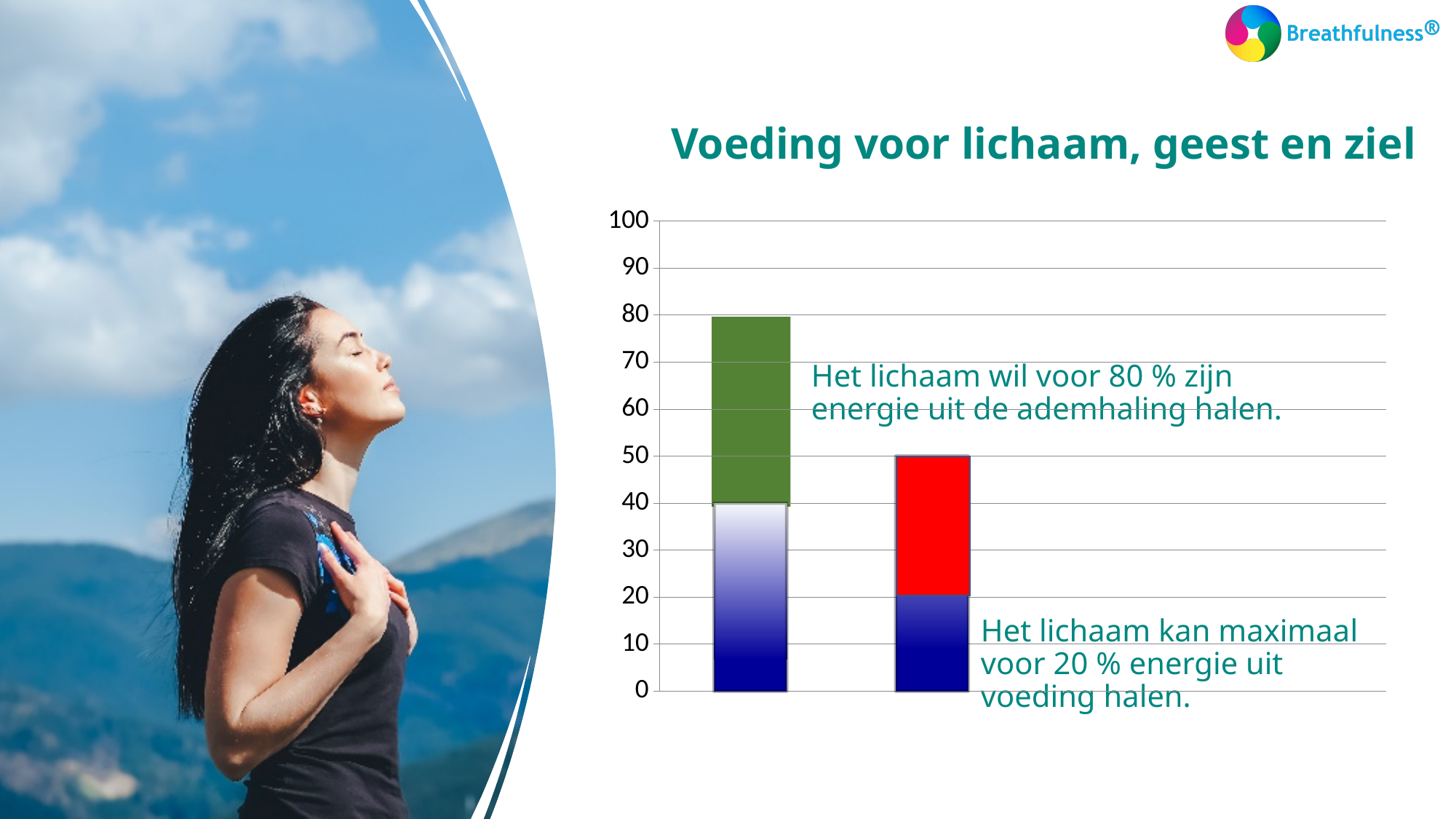
What value does the dark blue bottom segment of the right bar reach? 20 What value does the blue bottom segment of the left bar reach? 40 How many bars are plotted in the chart? 2 Is the total of the right bar greater or less than 60? less What is the total height of the right bar? 50 What is the difference between the total of the left bar and the total of the right bar? 30 Which bar is taller, the left bar or the right bar? The left bar What kind of chart is shown on the slide? Stacked bar chart How large is the red segment of the right bar? 30 What is the total height of the left bar? 80 What is the title of the slide above the chart? Voeding voor lichaam, geest en ziel How large is the green segment of the left bar? 40